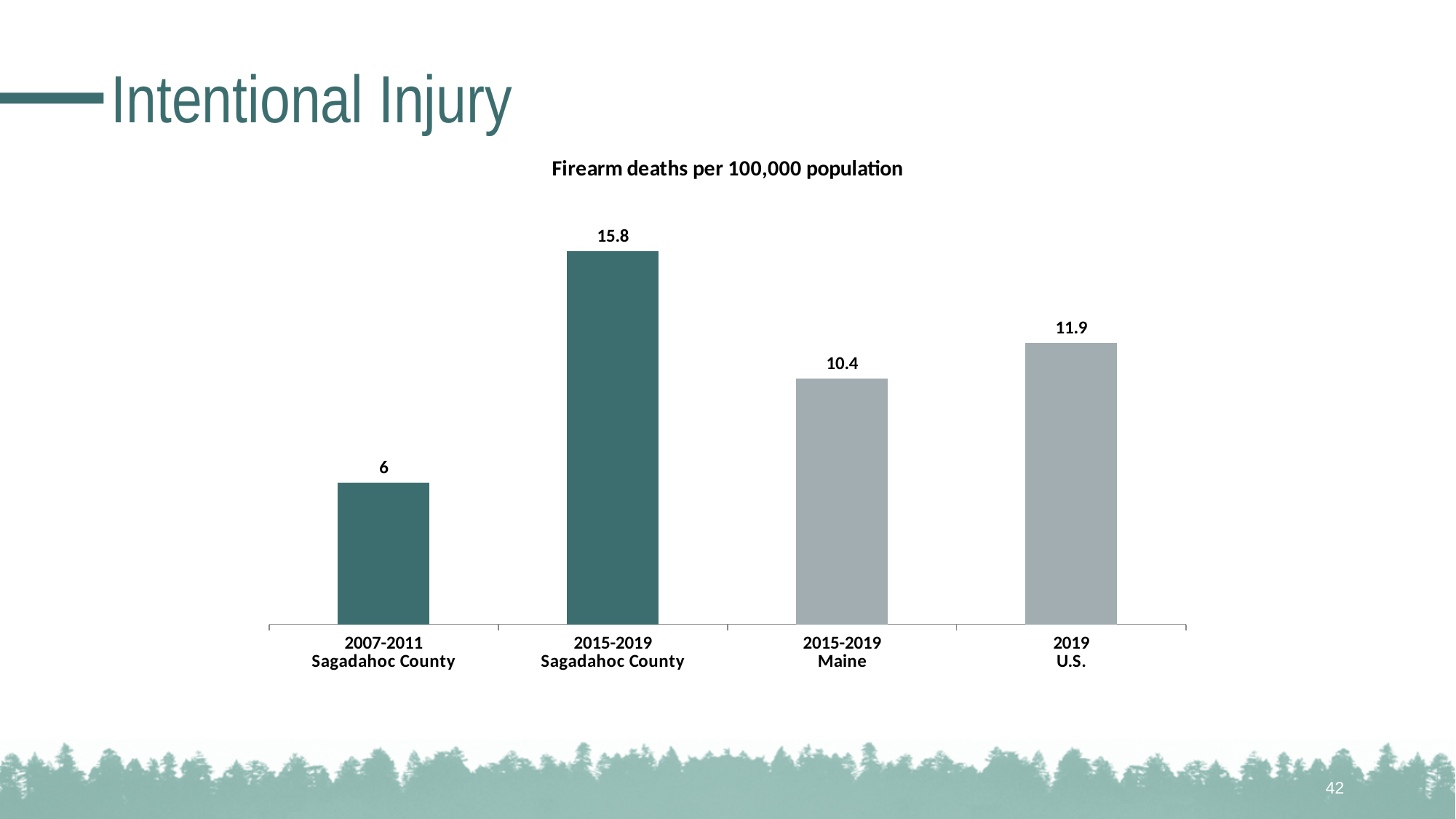
What is the difference between the 2019 U.S. value and the 2015-2019 Maine value? 1.5 What is the value for 2019 U.S.? 11.9 How many bars are shown in the chart? 4 What is the value for 2007-2011 Sagadahoc County? 6 What is the value for 2015-2019 Maine? 10.4 Which is larger, the value for 2015-2019 Maine or the value for 2019 U.S.? 2019 U.S. What is the title of the chart? Firearm deaths per 100,000 population Which category has the lowest firearm death rate? 2007-2011 Sagadahoc County Which category has the highest firearm death rate? 2015-2019 Sagadahoc County What is the difference between the 2015-2019 Sagadahoc County value and the 2007-2011 Sagadahoc County value? 9.8 What kind of chart is shown on the slide? Bar chart What is the value for 2015-2019 Sagadahoc County? 15.8